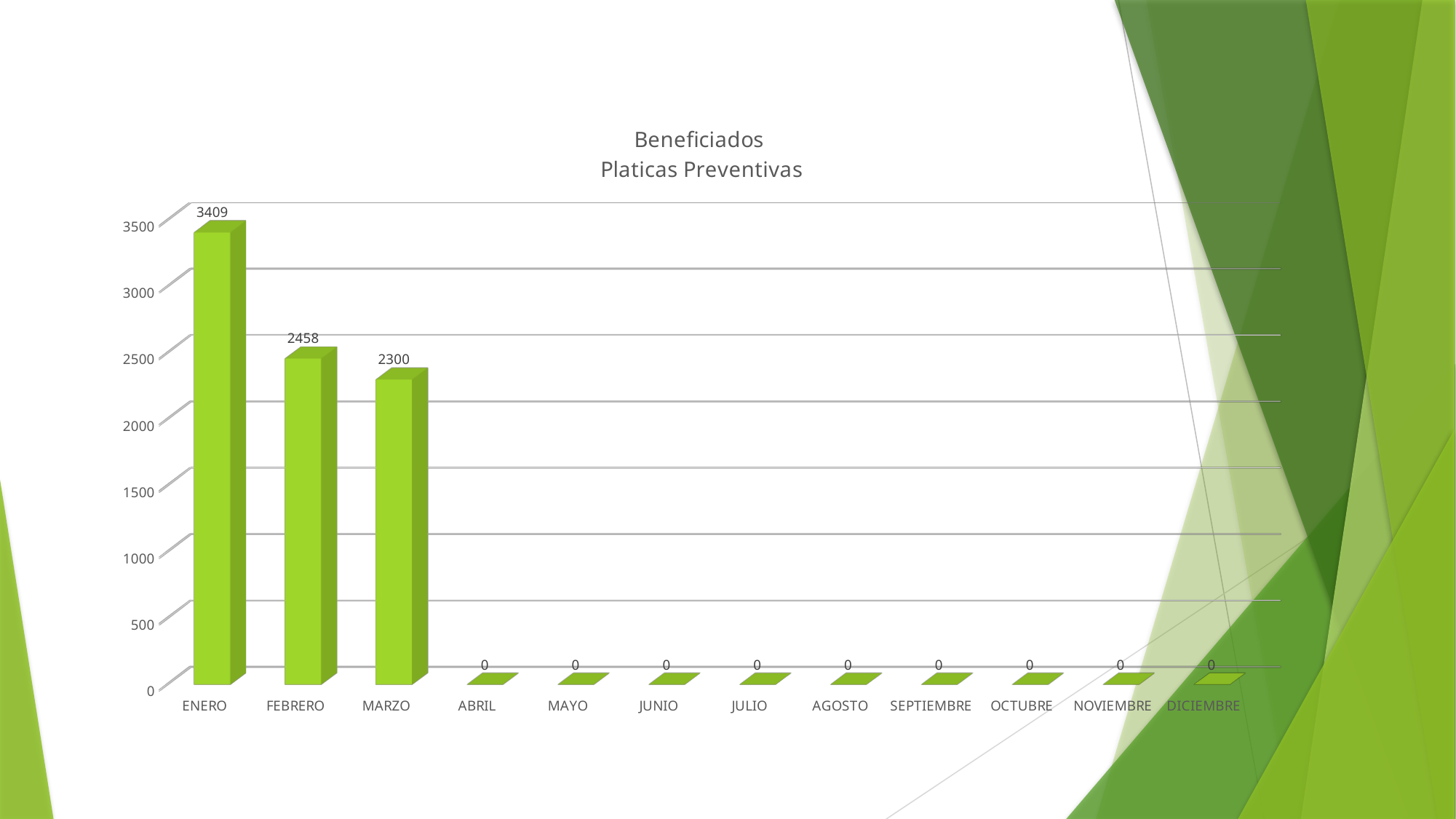
What is the value for MARZO? 2300 What is the difference between the values for ENERO and FEBRERO? 951 Is the value for ENERO greater or less than 3000? greater Which month has the highest value? ENERO What is the value for FEBRERO? 2458 How many months are shown on the x axis? 12 What is the difference between the values for FEBRERO and MARZO? 158 Which is larger, the value for FEBRERO or the value for MARZO? FEBRERO What is the title of the chart? Beneficiados Platicas Preventivas What kind of chart is shown on the slide? Bar chart What is the value for ENERO? 3409 What is the value for ABRIL? 0